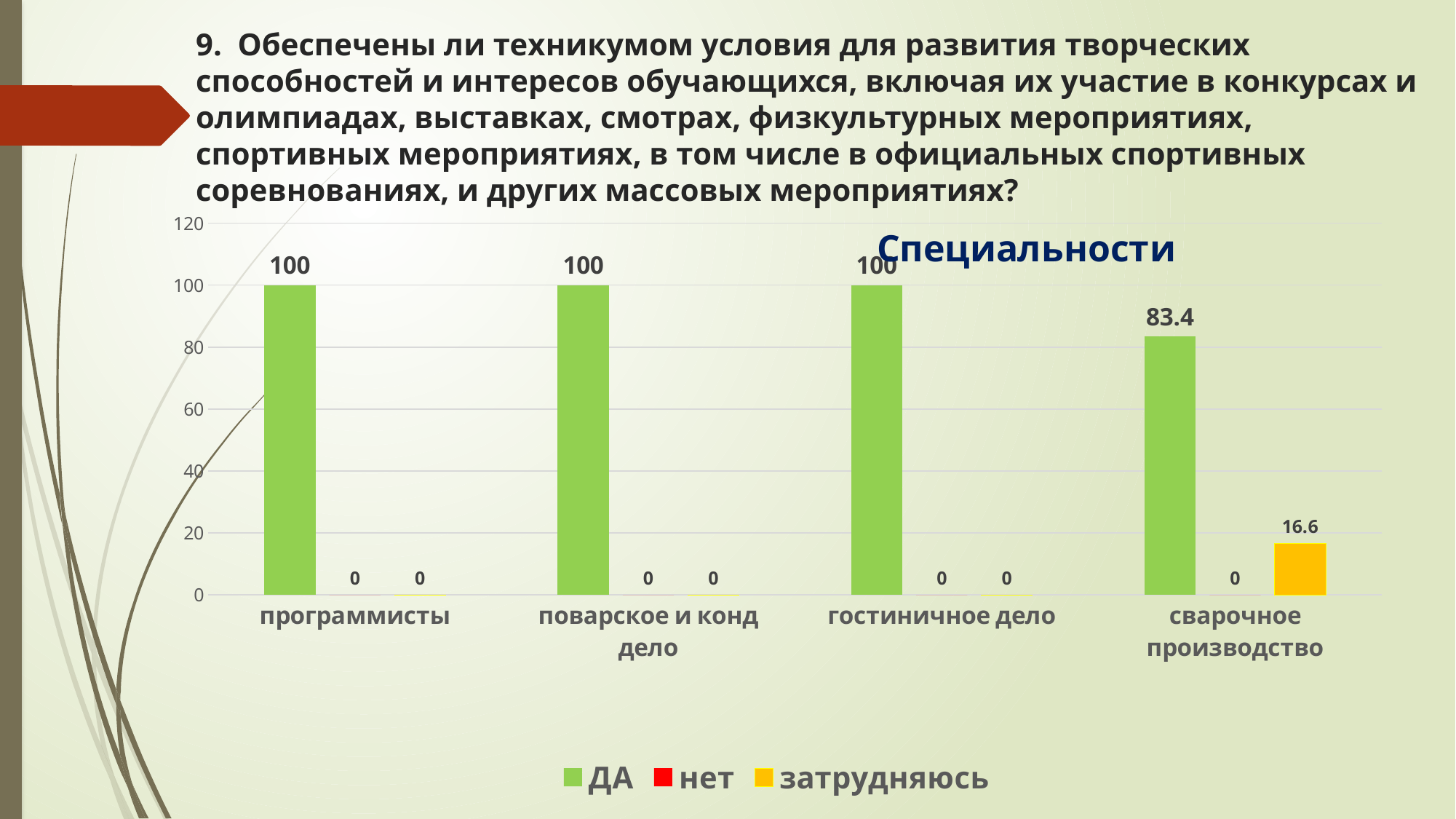
What is the difference between ДА and затрудняюсь for сварочное производство? 66.8 What is the value of затрудняюсь for сварочное производство? 16.6 Which category has the highest value for затрудняюсь? сварочное производство Which category has the lowest value for ДА? сварочное производство What kind of chart is shown on the slide? bar chart What is the value of ДА for программисты? 100 Which is larger for сварочное производство: ДА or затрудняюсь? ДА How many categories are shown on the x axis? 4 What is the value of нет for гостиничное дело? 0 What colour represents the series затрудняюсь in the legend? yellow What is the value of ДА for сварочное производство? 83.4 How many series does the legend list? 3